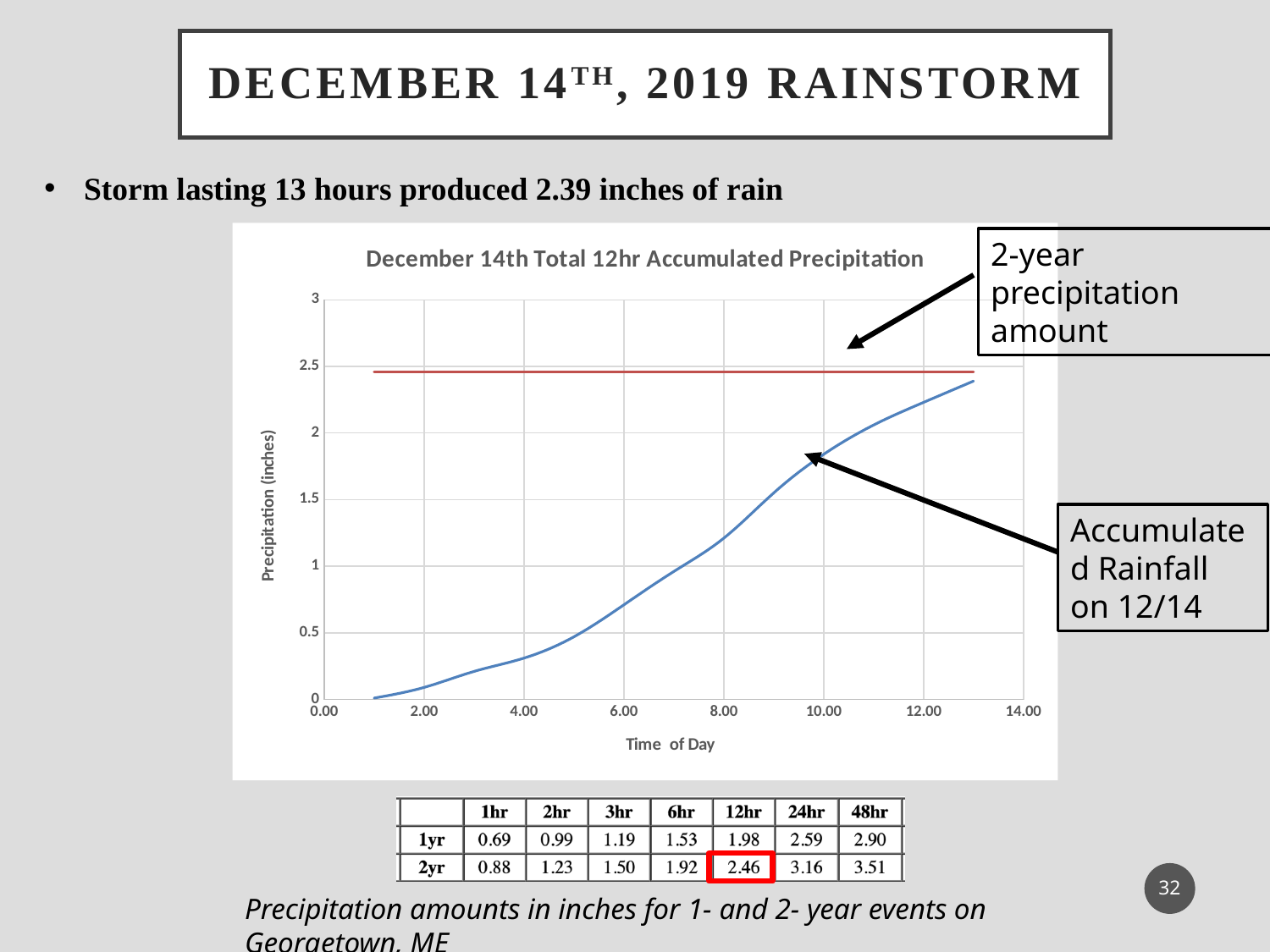
Is the accumulated rainfall at time 4.00 greater or less than 0.5 inches? less Does the blue accumulated rainfall line rise or fall as time of day increases? rise Is the accumulated rainfall at time 6.00 greater or less than 1 inch? less Is the accumulated rainfall at time 8.00 greater or less than 1 inch? greater At time 10.00, which line is higher: the red 2-year precipitation line or the blue accumulated rainfall line? the red 2-year precipitation line What kind of chart is shown on the slide? line chart What is the label of the vertical axis of the chart? Precipitation (inches) What is the highest value shown on the vertical axis of the chart? 3 What is the title of the chart? December 14th Total 12hr Accumulated Precipitation How many lines are plotted on the chart? 2